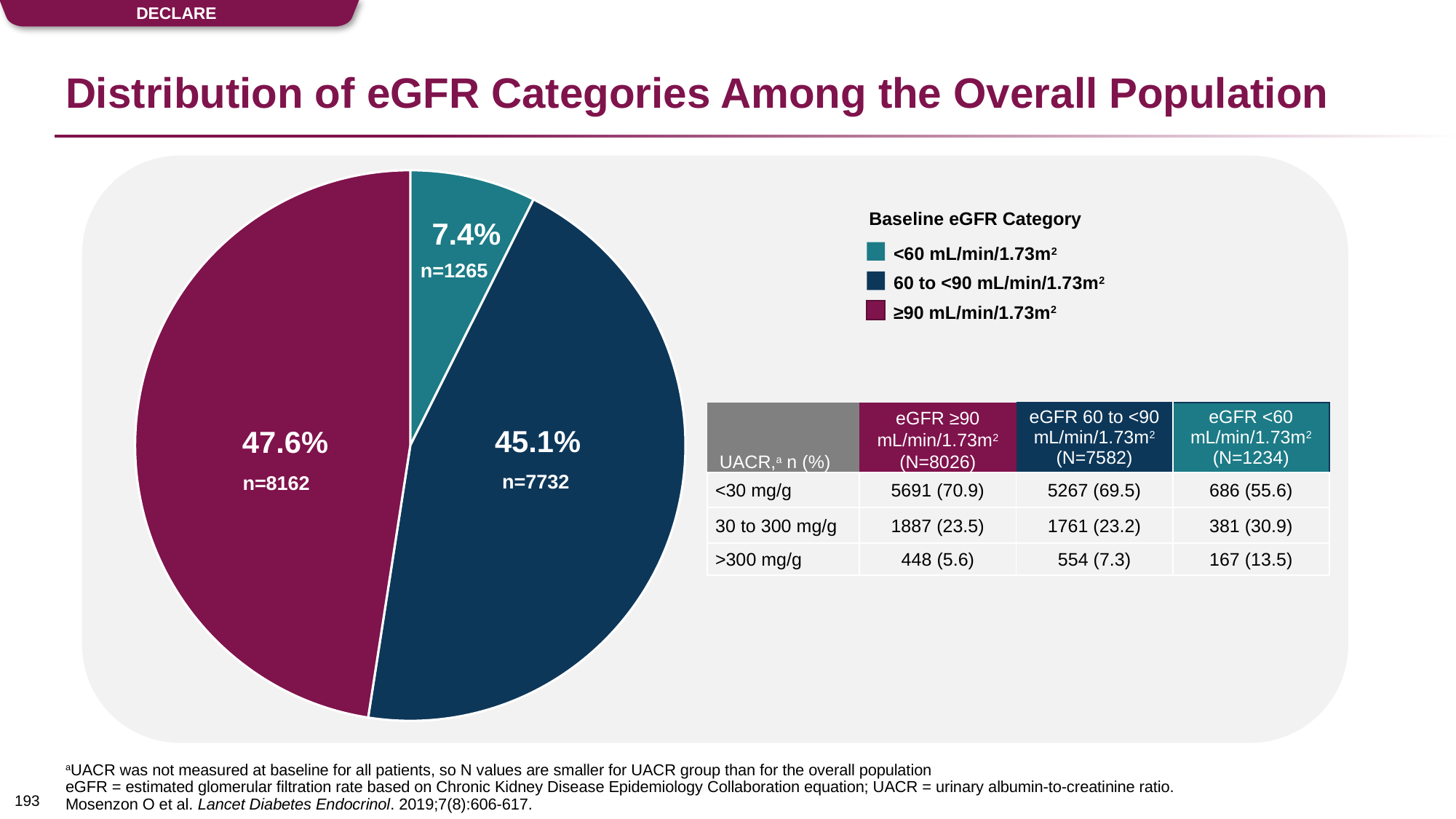
How many categories does the pie chart show? 3 Which category is larger: 60 to <90 mL/min/1.73m² or <60 mL/min/1.73m²? 60 to <90 mL/min/1.73m² How many patients were in the ≥90 mL/min/1.73m² eGFR category? n=8162 How many patients were in the <60 mL/min/1.73m² eGFR category? n=1265 What percentage of the overall population had a baseline eGFR of ≥90 mL/min/1.73m²? 47.6% Which baseline eGFR category has the largest share of the pie? ≥90 mL/min/1.73m² What percentage of the overall population had a baseline eGFR of <60 mL/min/1.73m²? 7.4% What colour represents the ≥90 mL/min/1.73m² category in the pie chart? Maroon (dark magenta) Which baseline eGFR category has the smallest share of the pie? <60 mL/min/1.73m² What type of chart is shown on the slide? Pie chart What is the difference in percentage points between the ≥90 mL/min/1.73m² and 60 to <90 mL/min/1.73m² categories? 2.5 percentage points What percentage of the overall population had a baseline eGFR of 60 to <90 mL/min/1.73m²? 45.1%